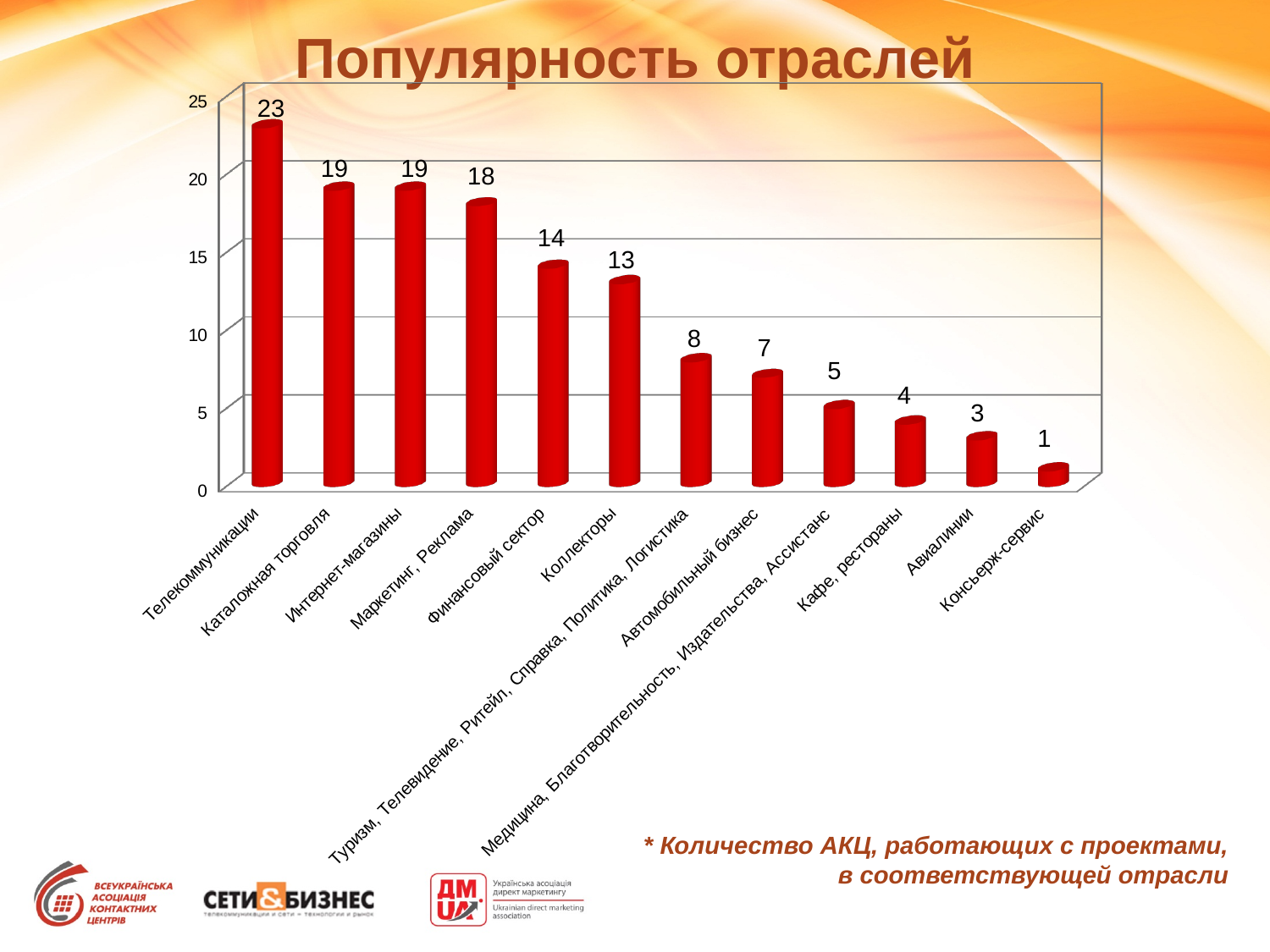
Which is larger, the value for Маркетинг, Реклама or the value for Автомобильный бизнес? Маркетинг, Реклама What is the value for Кафе, рестораны? 4 How many categories are shown on the chart? 12 What is the difference between the values for Телекоммуникации and Коллекторы? 10 What is the value for Телекоммуникации? 23 What is the title of the chart? Популярность отраслей Which category has the lowest value? Консьерж-сервис What kind of chart is shown on the slide? bar chart Which category has the highest value? Телекоммуникации What is the value for Финансовый сектор? 14 Do the values rise or fall from left to right along the x axis? fall What colour are the bars in the chart? red